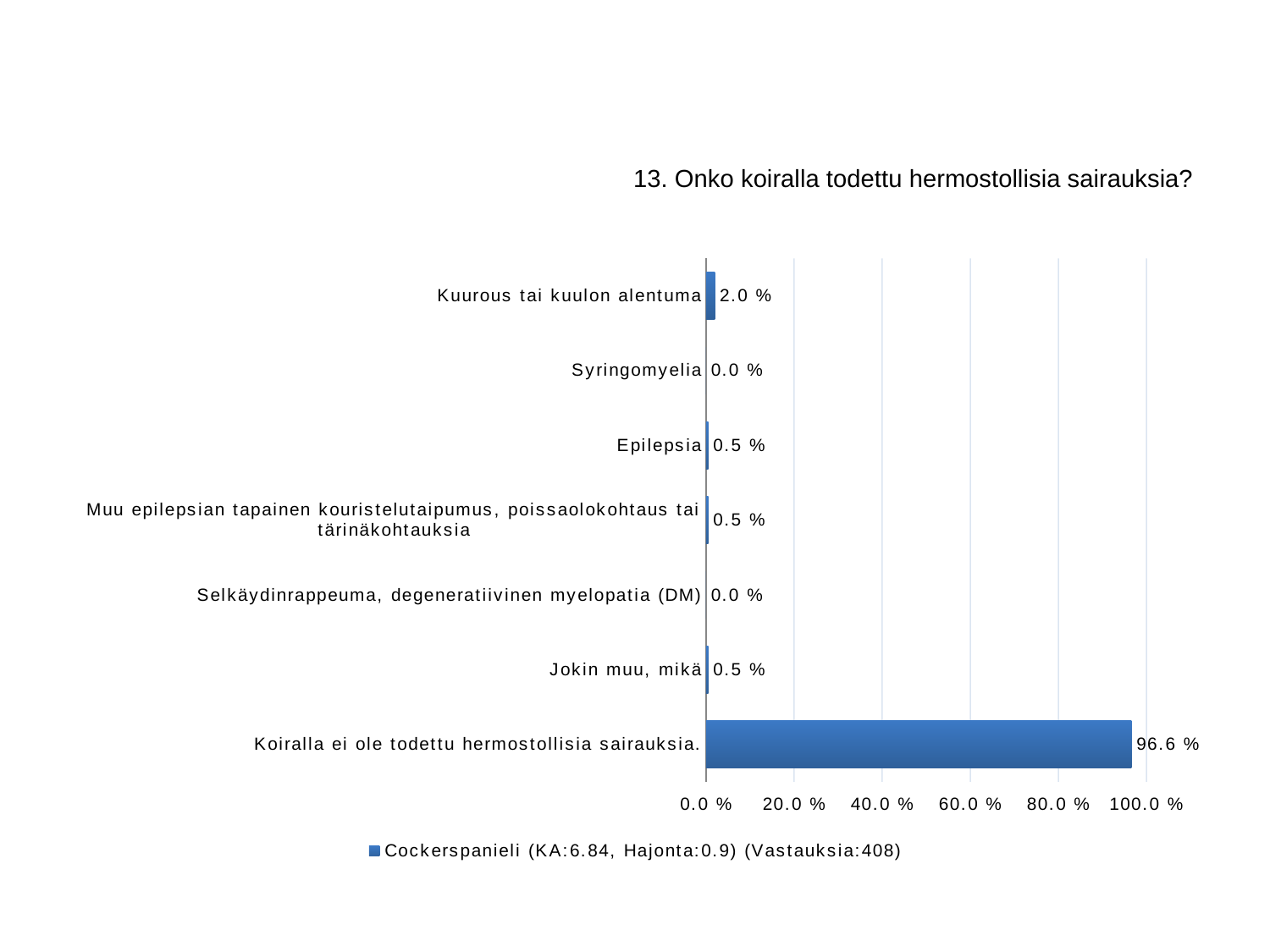
What is the value for "Koiralla ei ole todettu hermostollisia sairauksia."? 96.6 % What is the title of the chart? 13. Onko koiralla todettu hermostollisia sairauksia? How many categories are shown in the chart? 7 What kind of chart is shown on the slide? bar chart What is the value for "Kuurous tai kuulon alentuma"? 2.0 % What is the value for "Epilepsia"? 0.5 % What is the value for "Syringomyelia"? 0.0 % Which category has the highest value? Koiralla ei ole todettu hermostollisia sairauksia. What is the difference between the values for "Koiralla ei ole todettu hermostollisia sairauksia." and "Kuurous tai kuulon alentuma"? 94.6 % Which is larger, the value for "Kuurous tai kuulon alentuma" or the value for "Epilepsia"? Kuurous tai kuulon alentuma Is the value for "Koiralla ei ole todettu hermostollisia sairauksia." greater or less than 80.0 %? greater How many series does the legend list? 1